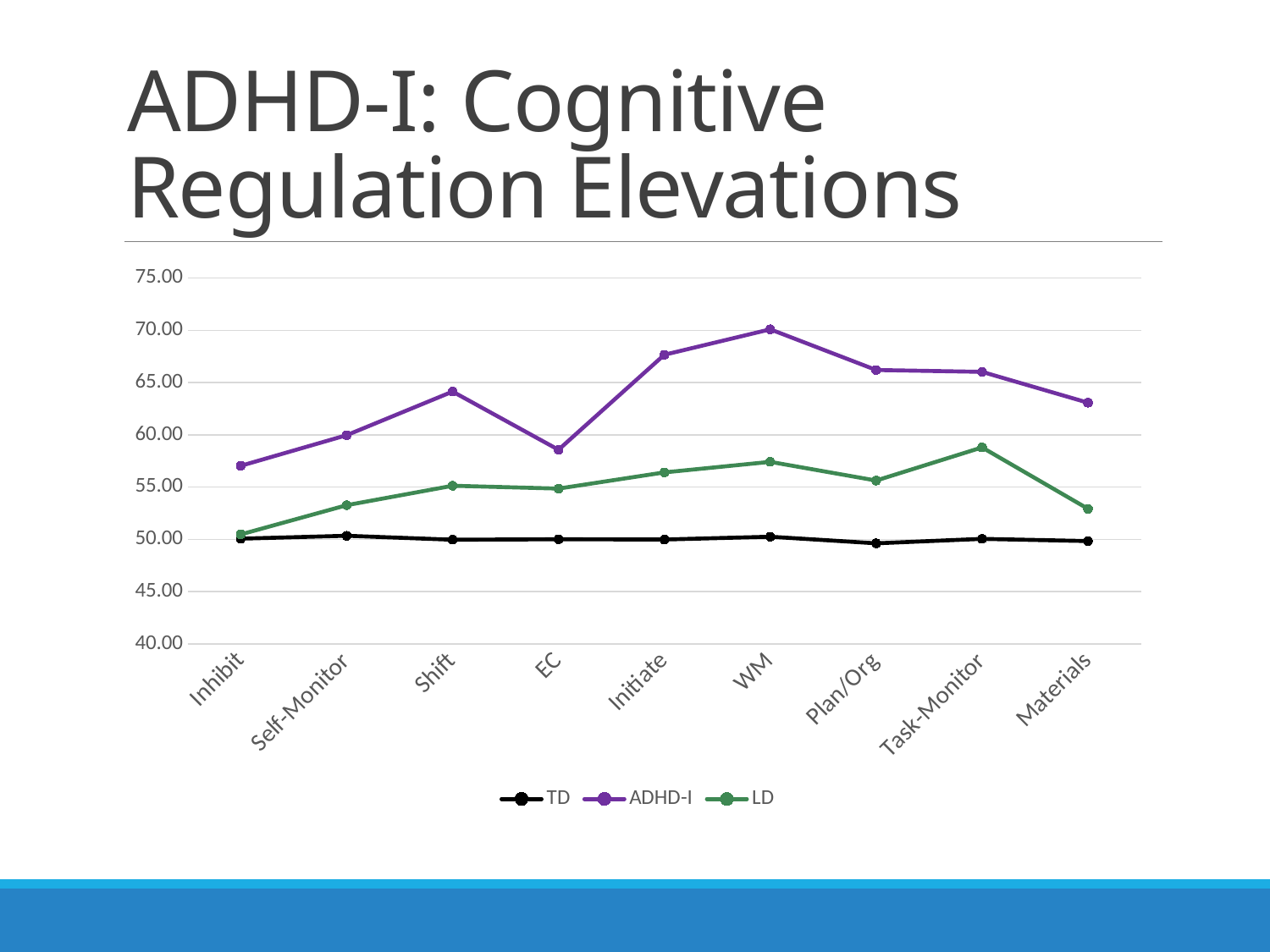
Is the ADHD-I value for EC greater or less than 60.00? less Does the ADHD-I line rise or fall from WM to Materials? fall For the LD series, which category has the highest value? Task-Monitor What kind of chart is shown on the slide? line chart At WM, which series has the larger value, ADHD-I or LD? ADHD-I How many series does the legend list? 3 What is the title of the slide containing the chart? ADHD-I: Cognitive Regulation Elevations For the ADHD-I series, which category has the highest value? WM How many categories are plotted along the x axis? 9 For the ADHD-I series, which category has the lowest value? Inhibit Is the LD value for Materials greater or less than 55.00? less Is the ADHD-I value for Initiate greater or less than 65.00? greater